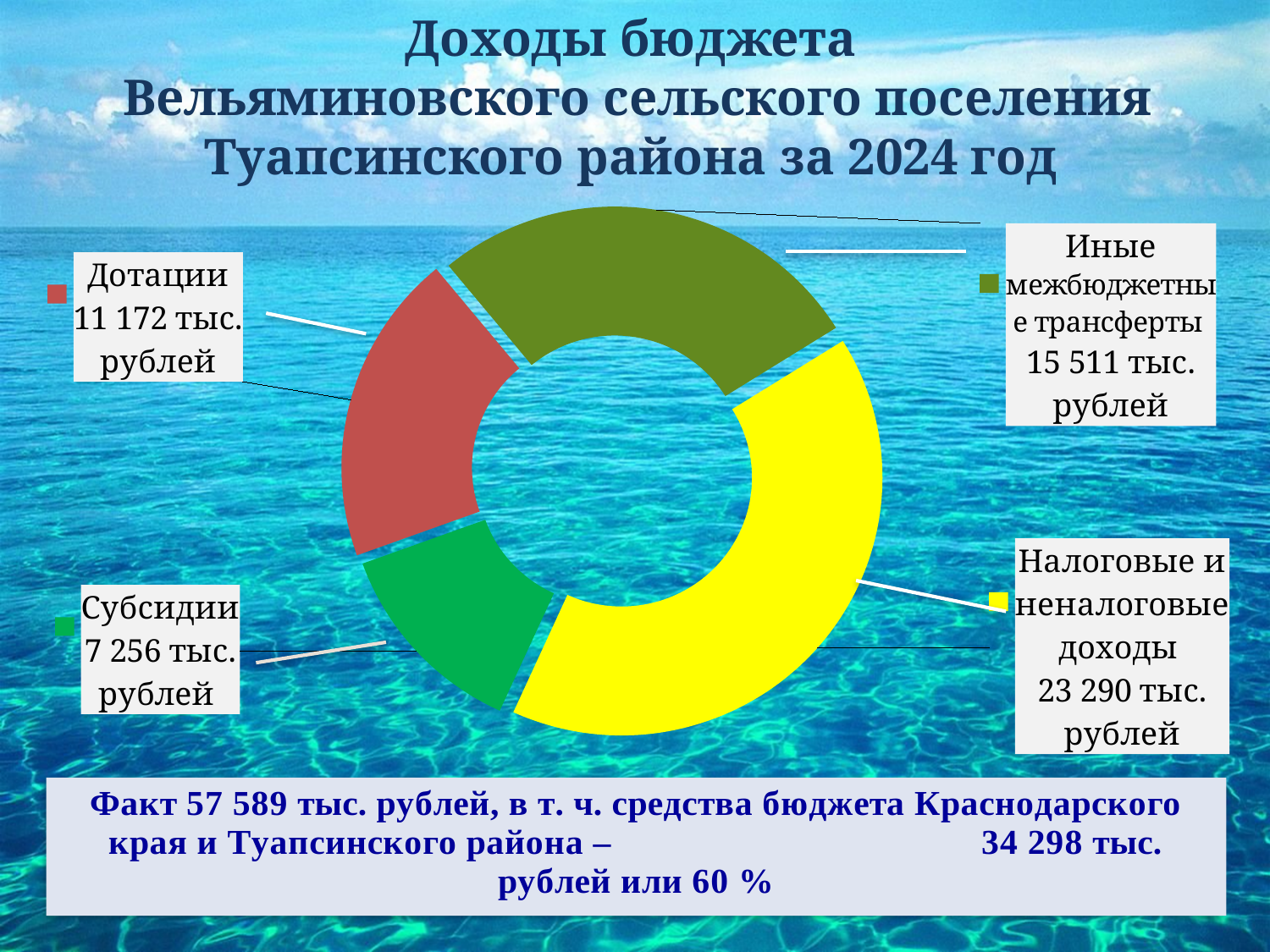
Which is larger, Дотации or Иные межбюджетные трансферты? Иные межбюджетные трансферты What kind of chart is shown on the slide? doughnut chart What is the value for Субсидии? 7 256 тыс. рублей What is the value for Иные межбюджетные трансферты? 15 511 тыс. рублей How many categories are shown in the chart? 4 Which category has the smallest value in the chart? Субсидии What is the value for Дотации? 11 172 тыс. рублей What is the value for Налоговые и неналоговые доходы? 23 290 тыс. рублей Which category has the largest value in the chart? Налоговые и неналоговые доходы What colour is the segment for Налоговые и неналоговые доходы? yellow What is the difference between Дотации and Субсидии? 3 916 тыс. рублей What is the difference between Налоговые и неналоговые доходы and Иные межбюджетные трансферты? 7 779 тыс. рублей